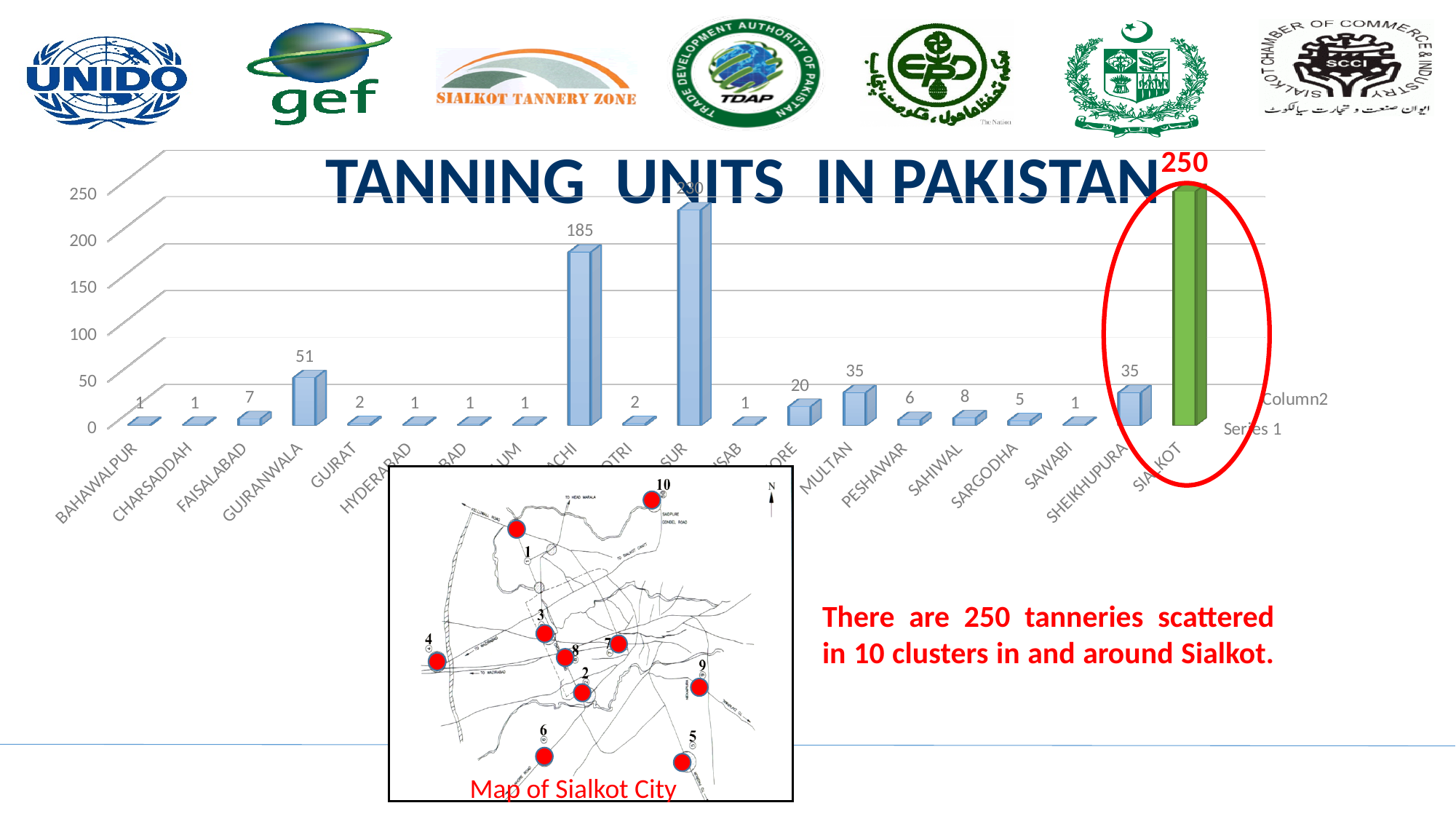
What is the value for MULTAN? 35 What type of chart is shown on the slide? bar chart What is the difference between the values for SIALKOT and GUJRANWALA? 199 What is the value for SAHIWAL? 8 How many bars (cities) are plotted in the chart? 20 How many tanning units are shown for SIALKOT? 250 What is the value for FAISALABAD? 7 Which city has the highest number of tanning units? SIALKOT What is the title of the chart? TANNING UNITS IN PAKISTAN Which has a larger value, GUJRANWALA or MULTAN? GUJRANWALA How many tanning units are shown for GUJRANWALA? 51 Is the value for SIALKOT greater or less than 200? greater